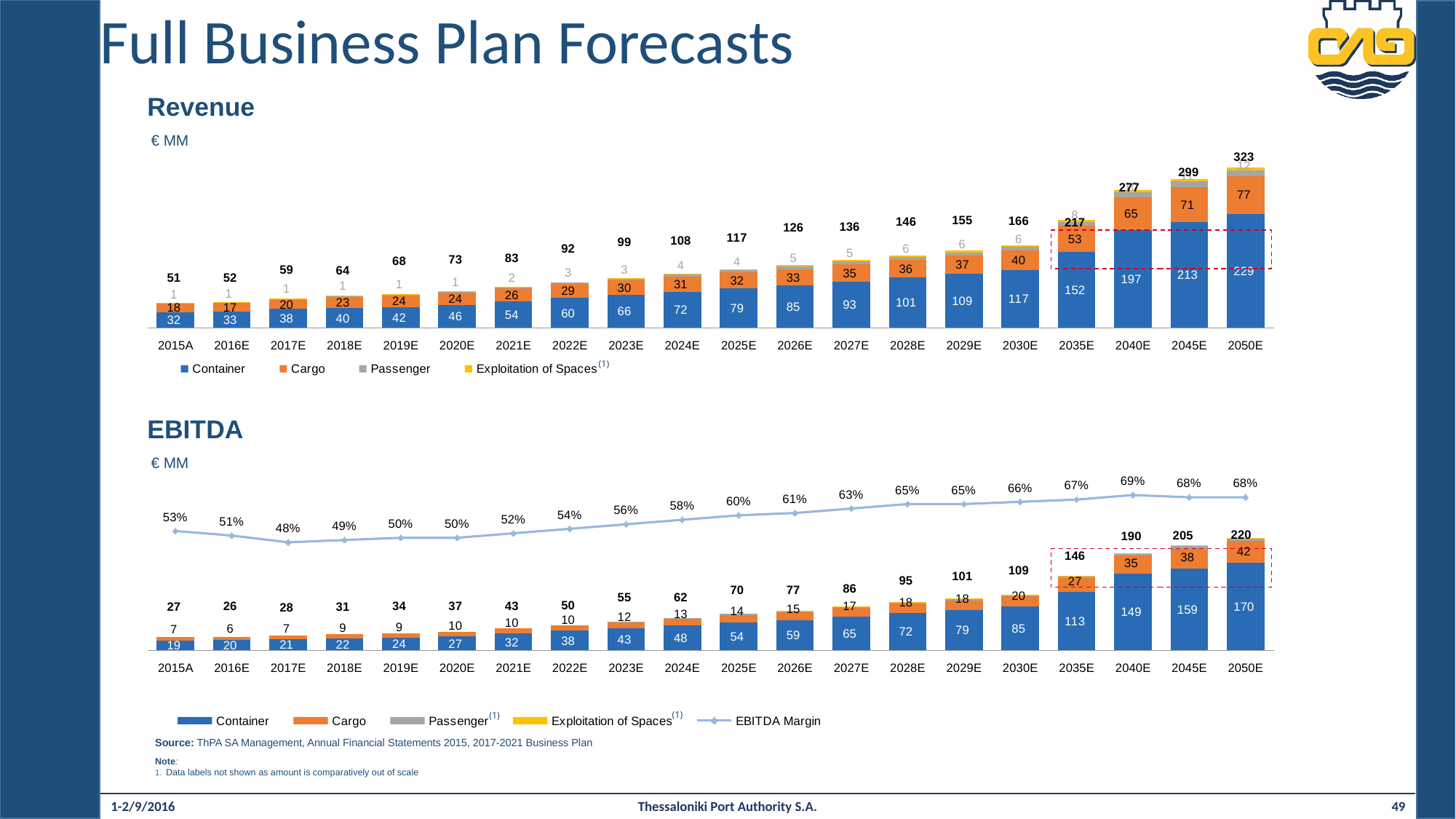
In the EBITDA chart, is the Container value larger for 2035E or 2030E? 2035E In the Revenue chart, what is the Container value for 2030E? 117 In the Revenue chart, what is the total revenue shown for 2050E? 323 In the EBITDA chart, what is the total EBITDA for 2028E? 95 How many entries does the legend of the EBITDA chart list? 5 In the EBITDA chart, which year has the lowest EBITDA Margin? 2017E How many years are shown on the x axis of the EBITDA chart? 20 In the EBITDA chart, what is the EBITDA Margin for 2040E? 69% In the Revenue chart, which year has the lowest total revenue? 2015A In the Revenue chart, what is the difference between the Container values for 2050E and 2045E? 16 In the Revenue chart, what is the Cargo value for 2035E? 53 Does the EBITDA Margin line generally rise or fall from 2017E to 2040E? rise